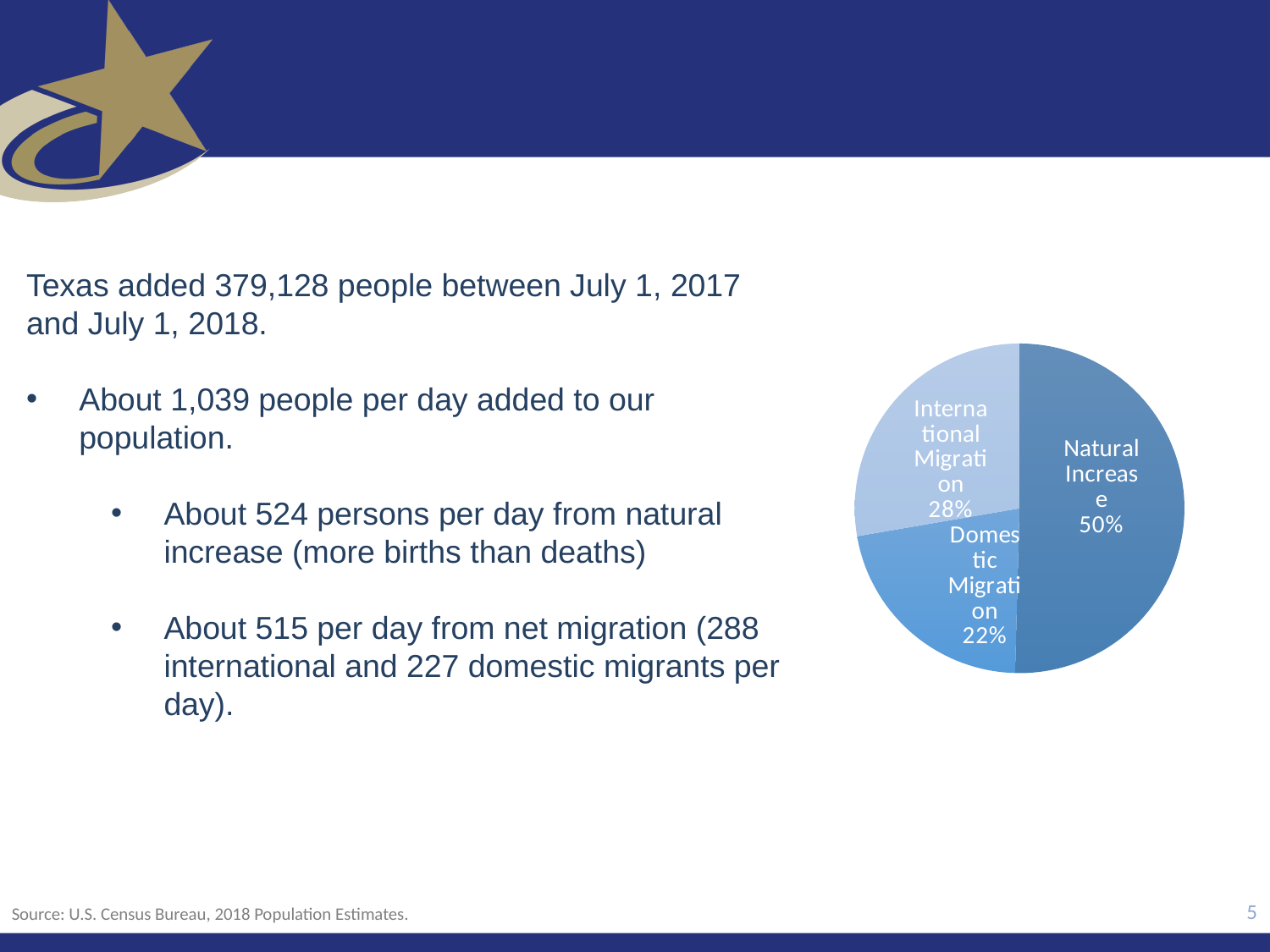
How many slices does the pie chart have? 3 Which slice of the pie chart is the smallest? Domestic Migration What is the difference in percentage points between the International Migration slice and the Domestic Migration slice? 6 What kind of chart is shown on the slide? pie chart Which is larger, the International Migration slice or the Domestic Migration slice? International Migration What share of the pie does Natural Increase represent? 50% What is the difference in percentage points between the Natural Increase slice and the International Migration slice? 22 Which slice of the pie chart is the largest? Natural Increase What share of the pie does Domestic Migration represent? 22% What share of the pie does International Migration represent? 28% What is the combined share of the International Migration and Domestic Migration slices? 50% Which slice of the pie chart is shown in the lightest shade of blue? International Migration